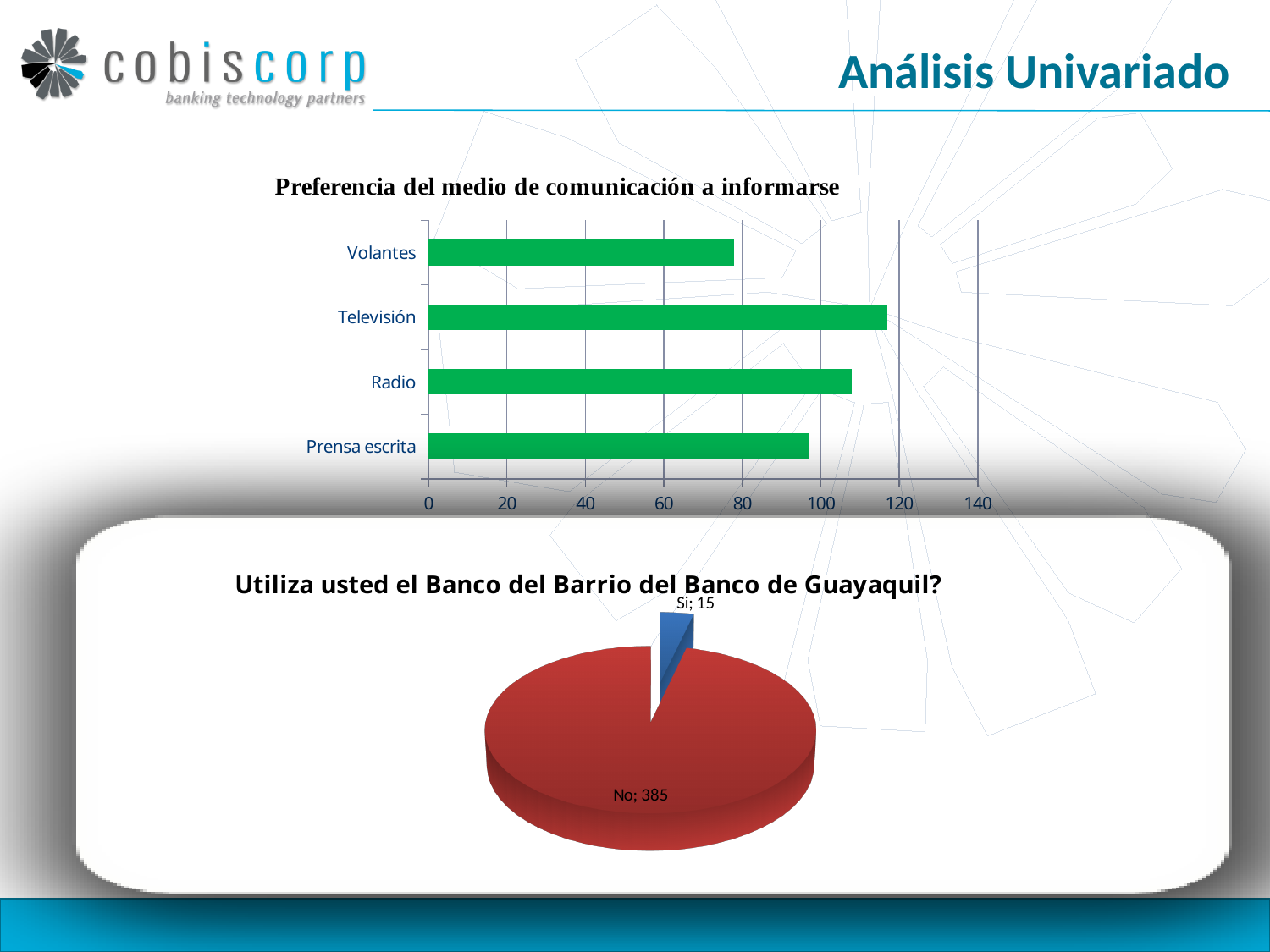
In the chart titled 'Preferencia del medio de comunicación a informarse', is the value for Volantes greater or less than 60? greater In the chart titled 'Utiliza usted el Banco del Barrio del Banco de Guayaquil?', what is the value for 'Si'? 15 In the chart titled 'Utiliza usted el Banco del Barrio del Banco de Guayaquil?', what is the value for 'No'? 385 What kind of chart is the one titled 'Utiliza usted el Banco del Barrio del Banco de Guayaquil?'? pie chart What kind of chart is the one titled 'Preferencia del medio de comunicación a informarse'? bar chart In the chart titled 'Preferencia del medio de comunicación a informarse', is the value for Radio greater or less than 100? greater In the chart titled 'Preferencia del medio de comunicación a informarse', how many categories are shown? 4 In the chart titled 'Preferencia del medio de comunicación a informarse', which category has the highest value? Televisión In the chart titled 'Preferencia del medio de comunicación a informarse', is the value for Televisión greater or less than 100? greater In the chart titled 'Preferencia del medio de comunicación a informarse', which is larger, the value for Radio or the value for Prensa escrita? Radio In the chart titled 'Preferencia del medio de comunicación a informarse', which category has the lowest value? Volantes In the chart titled 'Utiliza usted el Banco del Barrio del Banco de Guayaquil?', what is the difference between the 'No' and 'Si' values? 370